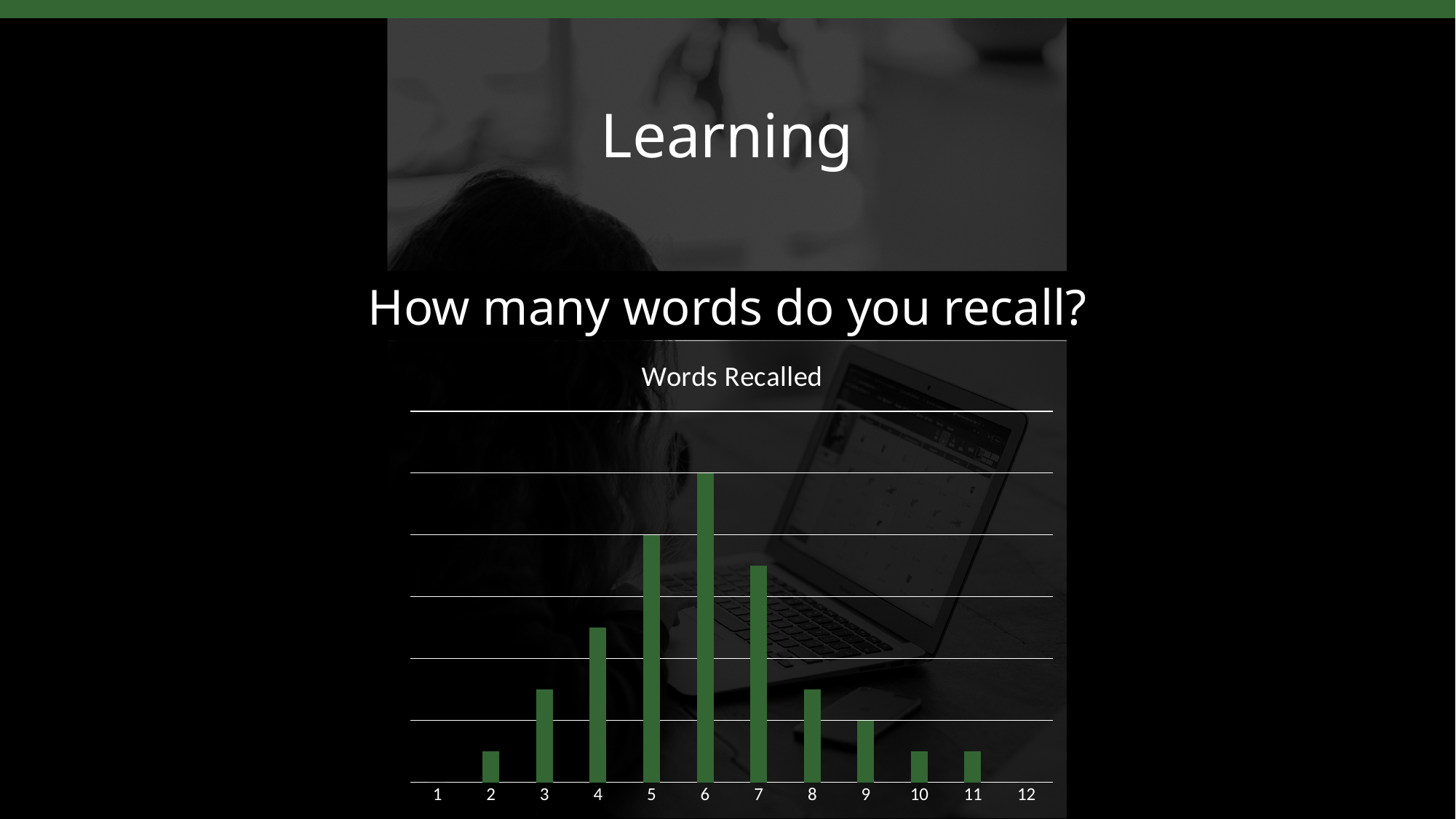
Which is larger, the value for category 5 or the value for category 7? 5 Which is larger, the value for category 3 or the value for category 2? 3 What type of chart is shown on the slide? bar chart Which category has the highest bar in the chart? 6 Do the values rise or fall from category 6 to category 11? fall What colour are the bars in the chart? green Which is larger, the value for category 6 or the value for category 8? 6 How many categories are shown on the x axis of the chart? 12 Do the values rise or fall from category 1 to category 6? rise What is the title of the chart? Words Recalled